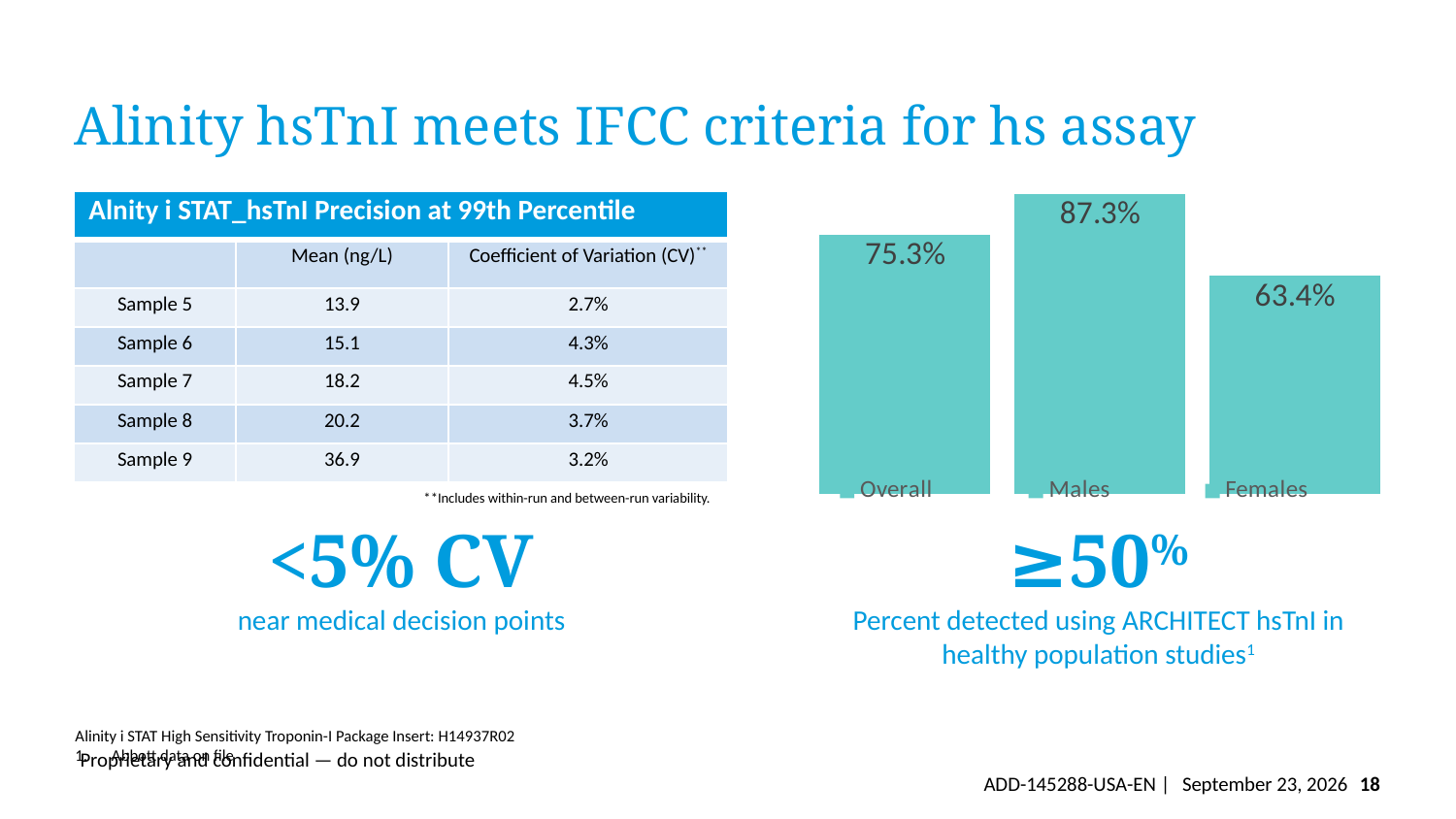
What kind of chart is shown on the right side of the slide? Bar chart What are the category labels along the x axis of the bar chart, from left to right? Overall, Males, Females What is the value for Overall in the bar chart? 75.3% How many categories are shown in the bar chart? 3 Which category has the highest value in the bar chart? Males What is the difference between the Males and Overall values in the bar chart? 12.0% What is the difference between the Males and Females values in the bar chart? 23.9% What colour are the bars in the bar chart? Teal Which is larger in the bar chart, the value for Overall or the value for Females? Overall What is the value for Females in the bar chart? 63.4% What is the value for Males in the bar chart? 87.3% Which category has the lowest value in the bar chart? Females